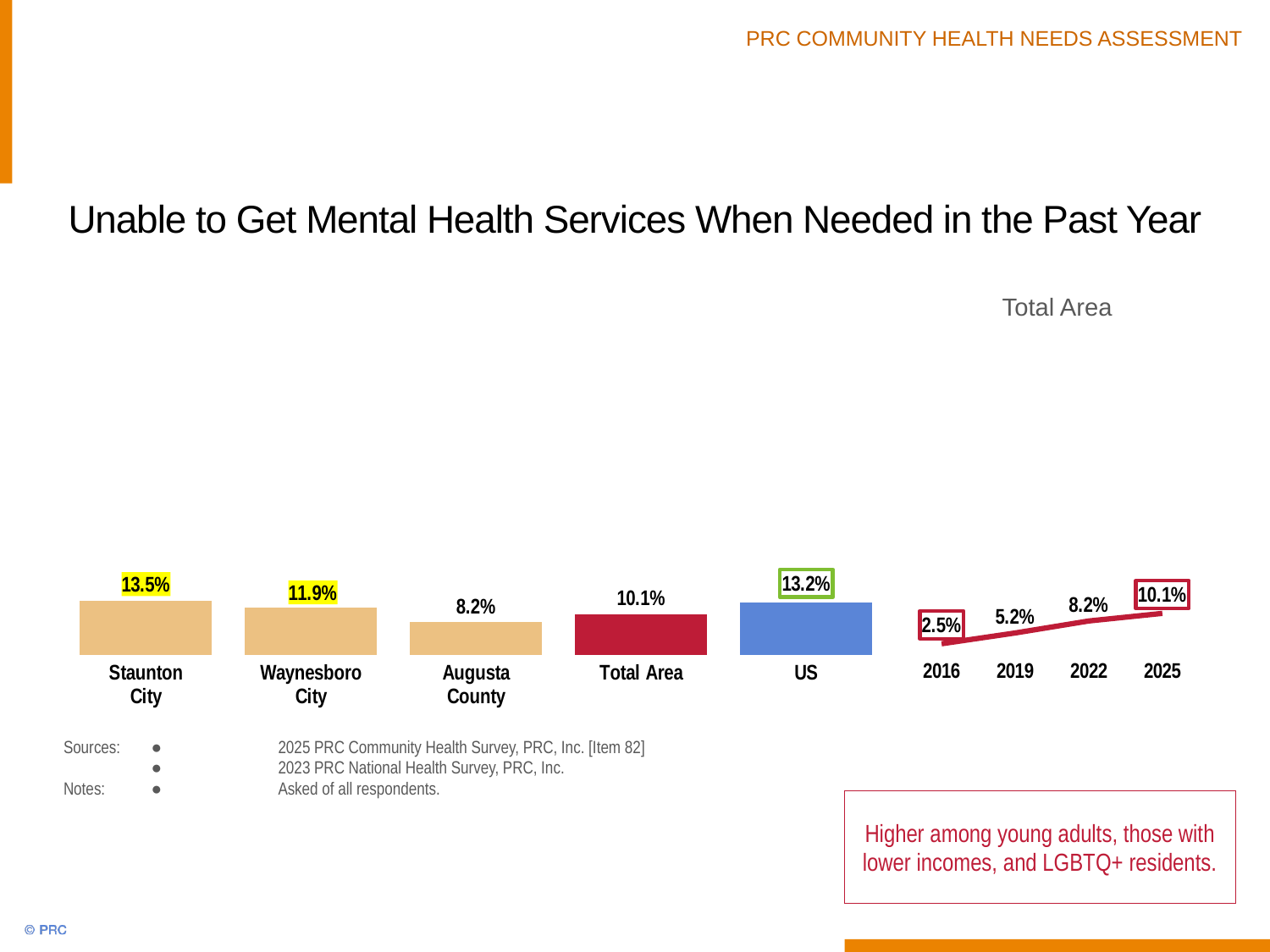
In the bar chart on the left, which category has the lowest value? Augusta County In the Total Area trend chart on the right, what is the difference between the 2025 value and the 2016 value? 7.6% In the Total Area trend chart on the right, do the values rise or fall from 2016 to 2025? Rise In the bar chart on the left, what is the difference between the Staunton City value and the Total Area value? 3.4% In the Total Area trend chart on the right, what is the value for 2016? 2.5% How many data points are plotted in the Total Area trend chart on the right? 4 In the bar chart on the left, which category has the highest value? Staunton City How many categories are shown in the bar chart on the left? 5 In the bar chart on the left, what is the value for Augusta County? 8.2% In the bar chart on the left, what is the value for Staunton City? 13.5% What kind of chart is the chart on the left? Bar chart In the bar chart on the left, which is larger, the value for Waynesboro City or the value for US? US